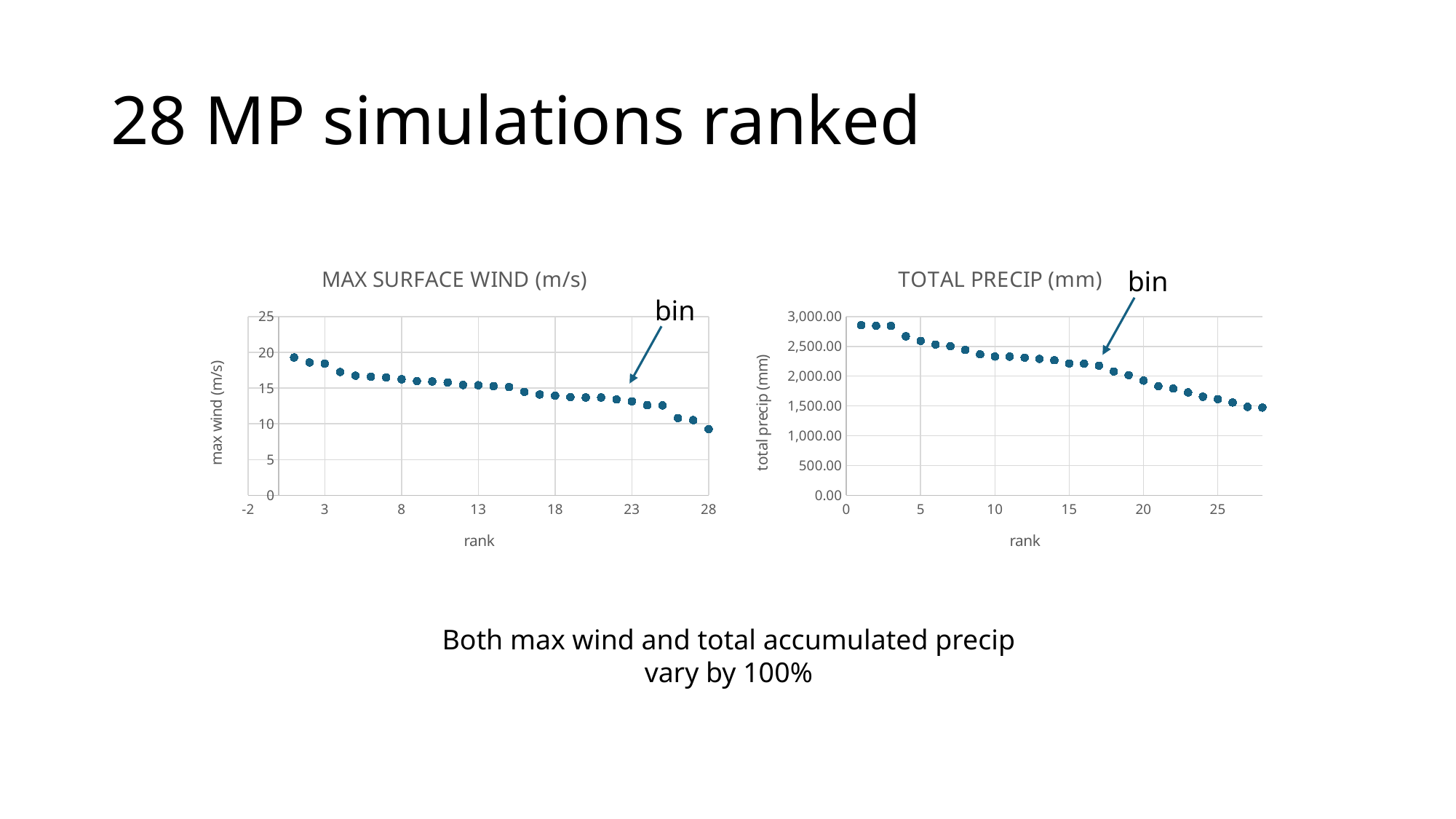
In the TOTAL PRECIP (mm) chart, is the value at rank 28 greater or less than 2,000.00? less In the TOTAL PRECIP (mm) chart, is the value at rank 10 greater or less than 2,000.00? greater In the TOTAL PRECIP (mm) chart, do the values rise or fall as rank increases? fall In the MAX SURFACE WIND (m/s) chart, do the values rise or fall as rank increases? fall In the MAX SURFACE WIND (m/s) chart, is the value at rank 28 greater or less than 10? less What kind of chart is the TOTAL PRECIP (mm) chart? scatter chart How many simulations (points) are plotted in the MAX SURFACE WIND (m/s) chart? 28 What is the x-axis label of the TOTAL PRECIP (mm) chart? rank What kind of chart is the MAX SURFACE WIND (m/s) chart? scatter chart What is the y-axis label of the MAX SURFACE WIND (m/s) chart? max wind (m/s)